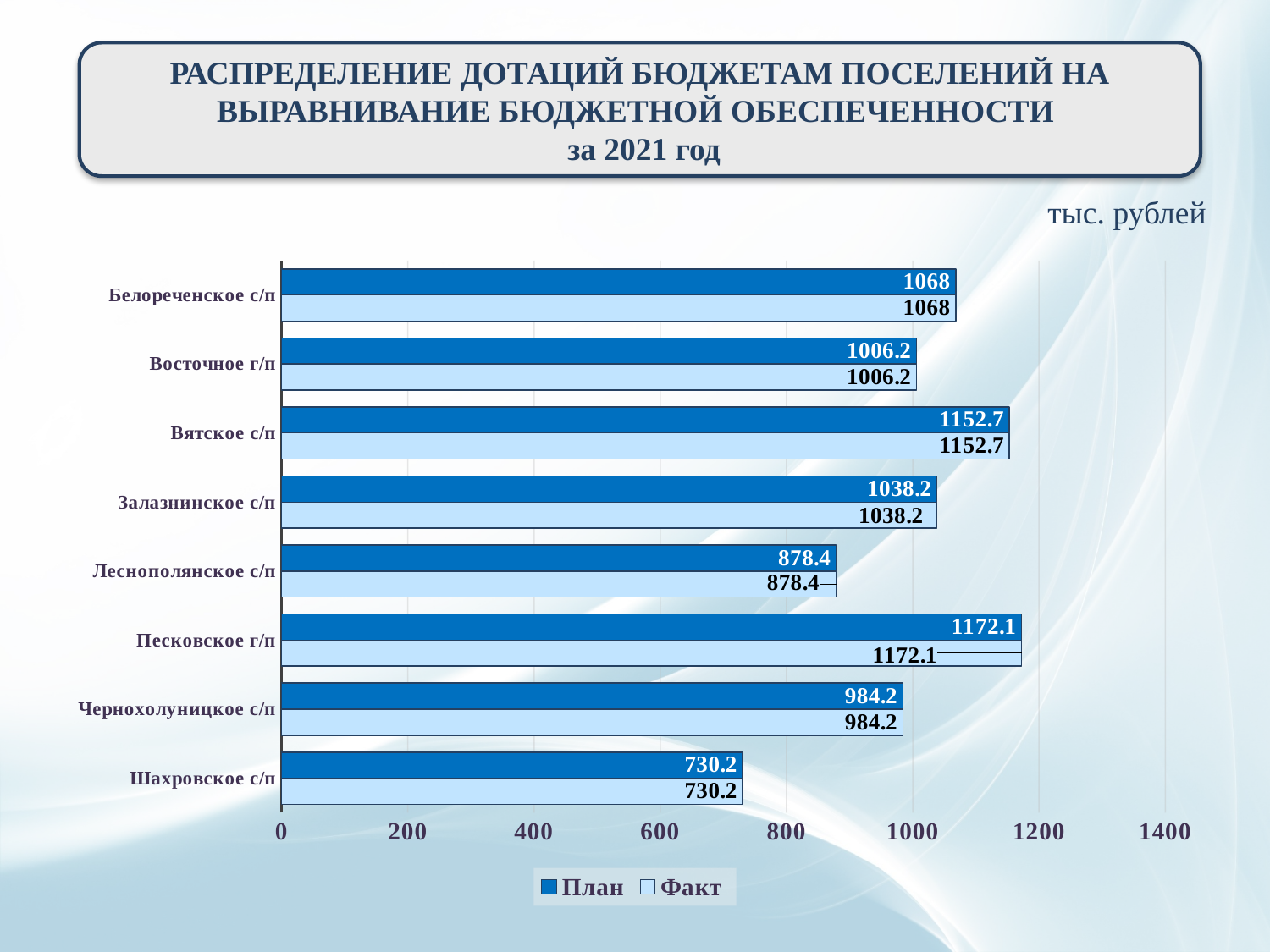
How many series does the legend list? 2 Which settlement has the highest Факт value? Песковское г/п Which settlement has the lowest План value? Шахровское с/п How many settlements are shown on the chart? 8 What kind of chart is shown on the slide? bar chart What unit of measurement is indicated above the chart? тыс. рублей Which is larger, the Факт value for Белореченское с/п or for Восточное г/п? Белореченское с/п What is the Факт value for Шахровское с/п? 730.2 What is the План value for Лесополянское с/п? 878.4 What is the difference between the План values for Песковское г/п and Шахровское с/п? 441.9 Is the План value for Чернохолуницкое с/п greater or less than 1000? less What is the План value for Вятское с/п? 1152.7